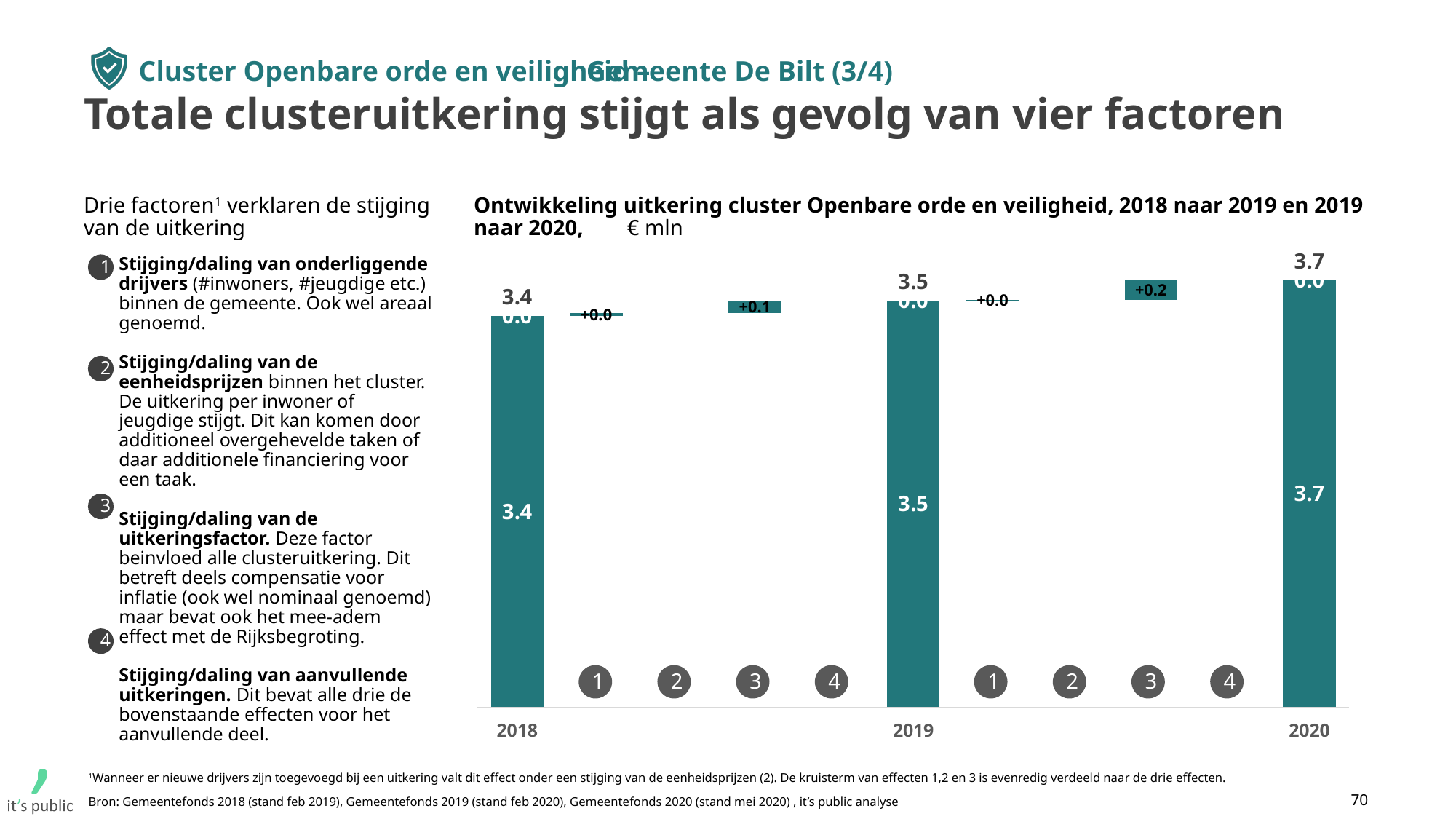
What is the difference between the 2019 total and the 2018 total? 0.1 What is the effect of factor 3 on the change from 2018 to 2019? +0.1 What is the effect of factor 3 on the change from 2019 to 2020? +0.2 What kind of chart is used to show the development of the cluster payment? bar chart What is the difference between the 2020 total and the 2018 total? 0.3 Which year has the lowest total cluster payment? 2018 What is the total cluster payment shown for 2020? 3.7 Do the total cluster payments rise or fall from 2018 to 2020? rise Which year has the highest total cluster payment? 2020 What is the total cluster payment shown for 2019? 3.5 In what unit are the values in the chart expressed? € mln What is the total cluster payment shown for 2018? 3.4